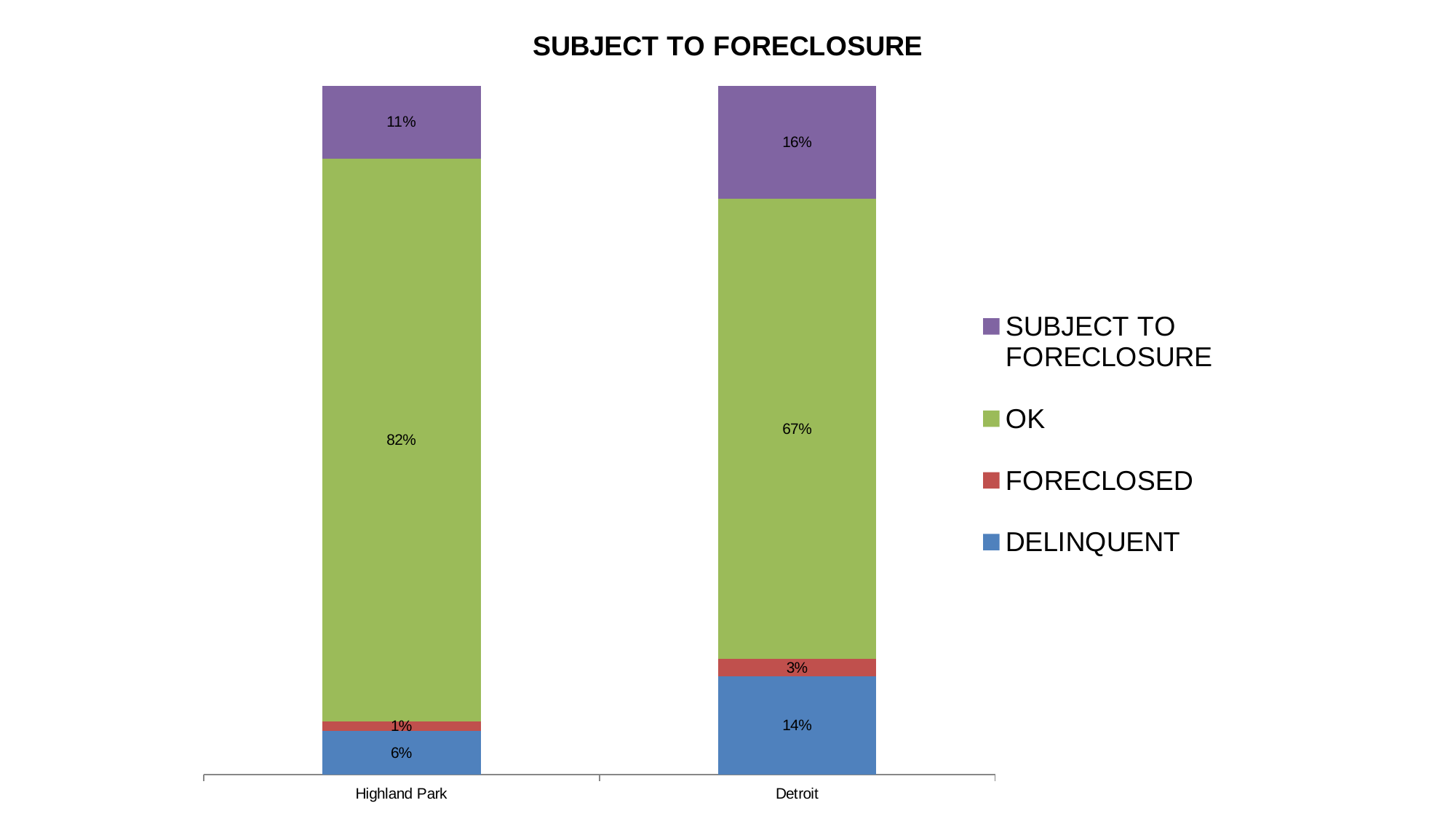
What is the difference between the SUBJECT TO FORECLOSURE values for Detroit and Highland Park? 5% What is the OK value for Highland Park? 82% How many series does the legend list? 4 Which category has the higher DELINQUENT value? Detroit How many categories are shown on the x axis? 2 Which category has the higher OK value, Highland Park or Detroit? Highland Park What is the title of the chart? SUBJECT TO FORECLOSURE What is the FORECLOSED value for Highland Park? 1% What is the difference between the OK values for Highland Park and Detroit? 15% What is the SUBJECT TO FORECLOSURE value for Detroit? 16% What is the DELINQUENT value for Detroit? 14% What kind of chart is shown on the slide? Stacked bar chart